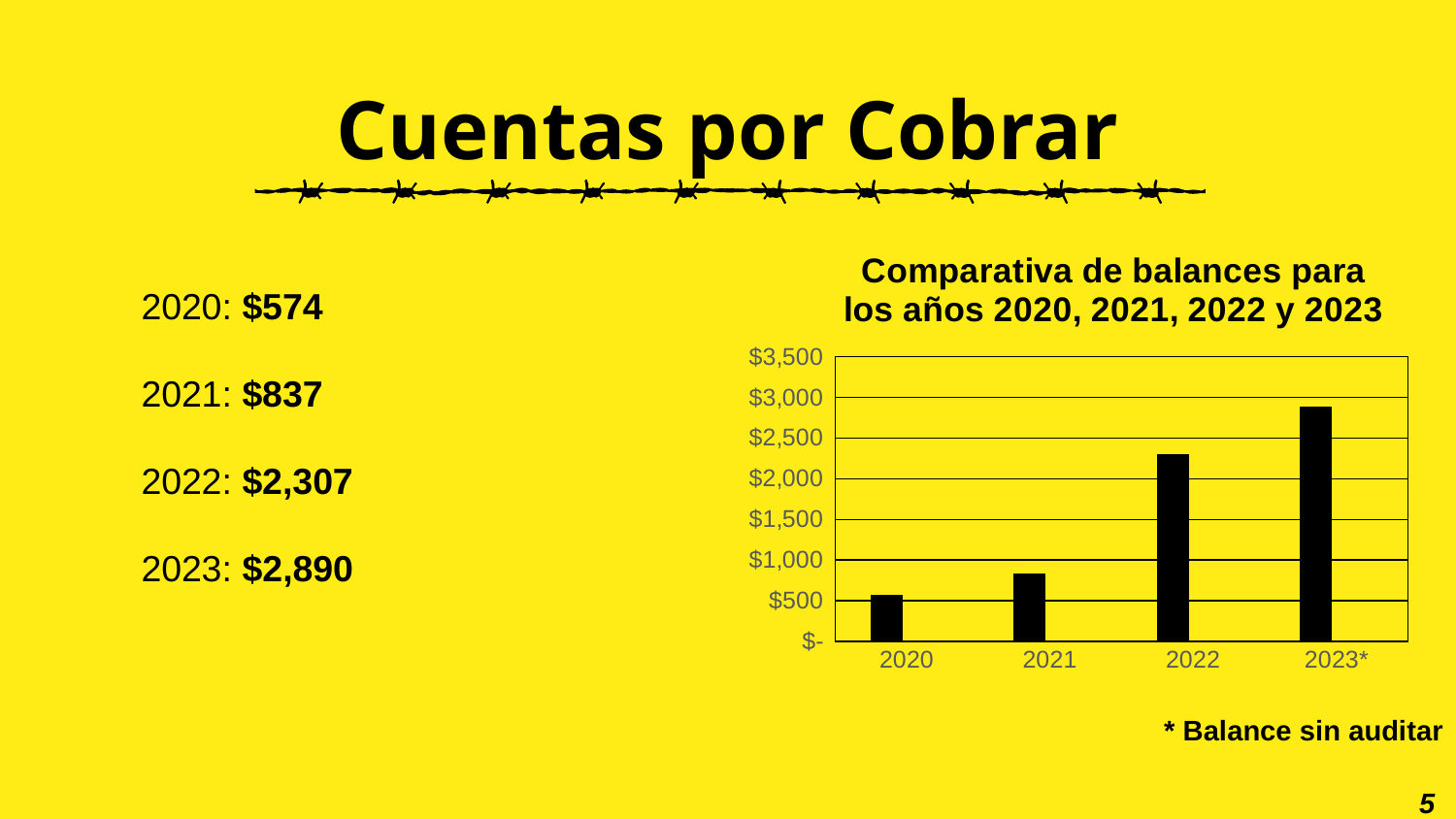
What type of chart is shown on the slide? bar chart Which year has the lowest balance in the chart? 2020 How many years (categories) are plotted in the chart? 4 What is the balance for 2020? $574 Is the value for 2022 greater or less than $2,000? greater What is the difference between the 2022 balance and the 2021 balance? $1,470 What is the difference between the 2023 balance and the 2020 balance? $2,316 Which year has the highest balance in the chart? 2023* What is the balance for 2022? $2,307 What is the title of the chart? Comparativa de balances para los años 2020, 2021, 2022 y 2023 Do the balances rise or fall from 2020 to 2023 along the x axis? rise Is the value for 2021 greater or less than $1,000? less